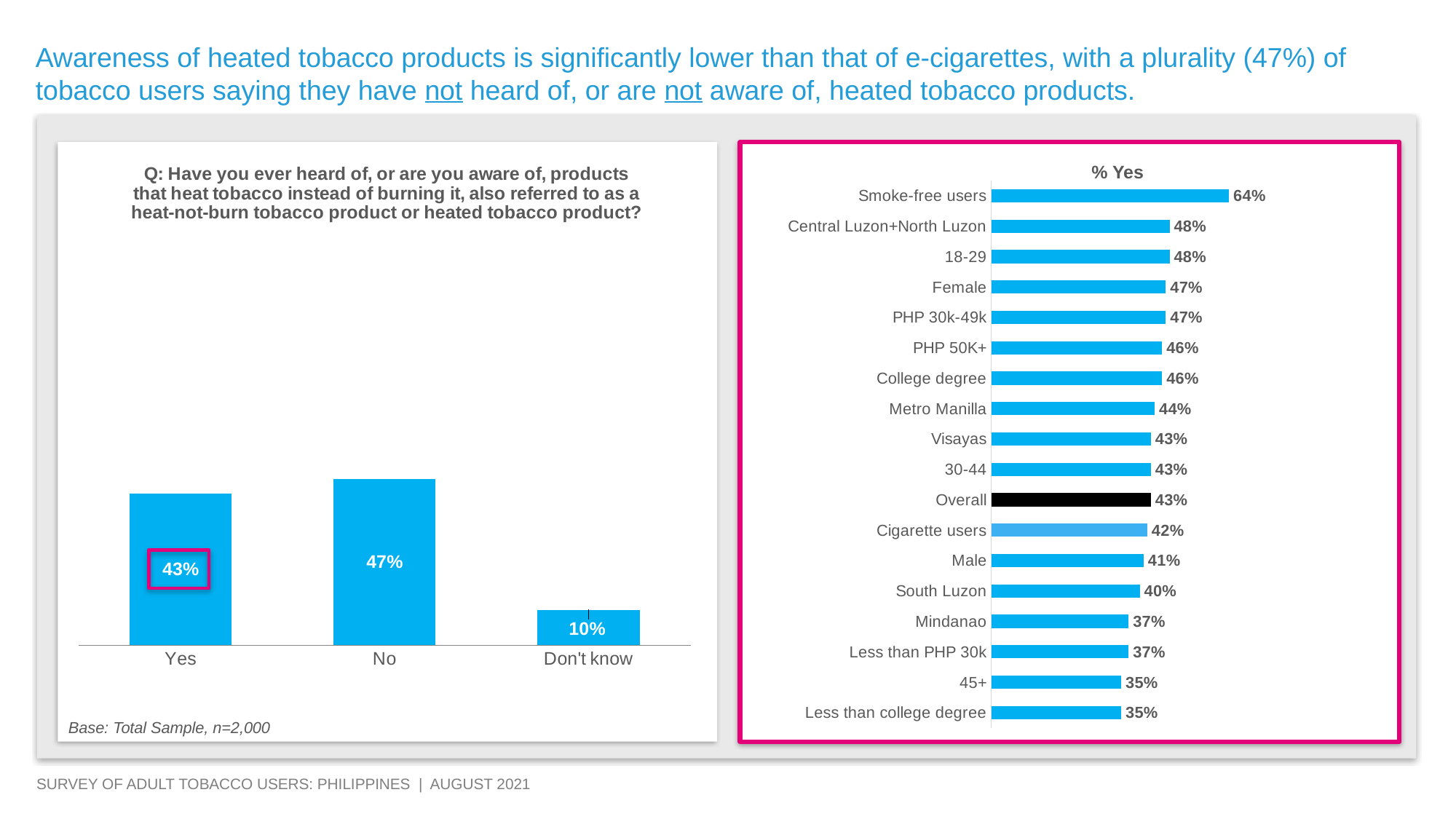
In the "% Yes" chart on the right, what is the value for Smoke-free users? 64% How many response categories are shown in the left chart? 3 In the left chart, what is the difference between the "No" and "Yes" percentages? 4% How many groups are listed in the "% Yes" chart on the right? 18 In the left chart, what percentage of respondents answered "Yes"? 43% In the "% Yes" chart on the right, which group has the highest value? Smoke-free users In the left chart, what percentage of respondents answered "Don't know"? 10% In the "% Yes" chart on the right, which is larger, the value for Female or the value for Male? Female What type of chart is the "% Yes" chart on the right? Bar chart In the "% Yes" chart on the right, what is the value for Metro Manilla? 44% In the "% Yes" chart on the right, what is the difference between Smoke-free users and Cigarette users? 22% In the left chart, which response category has the highest value? No